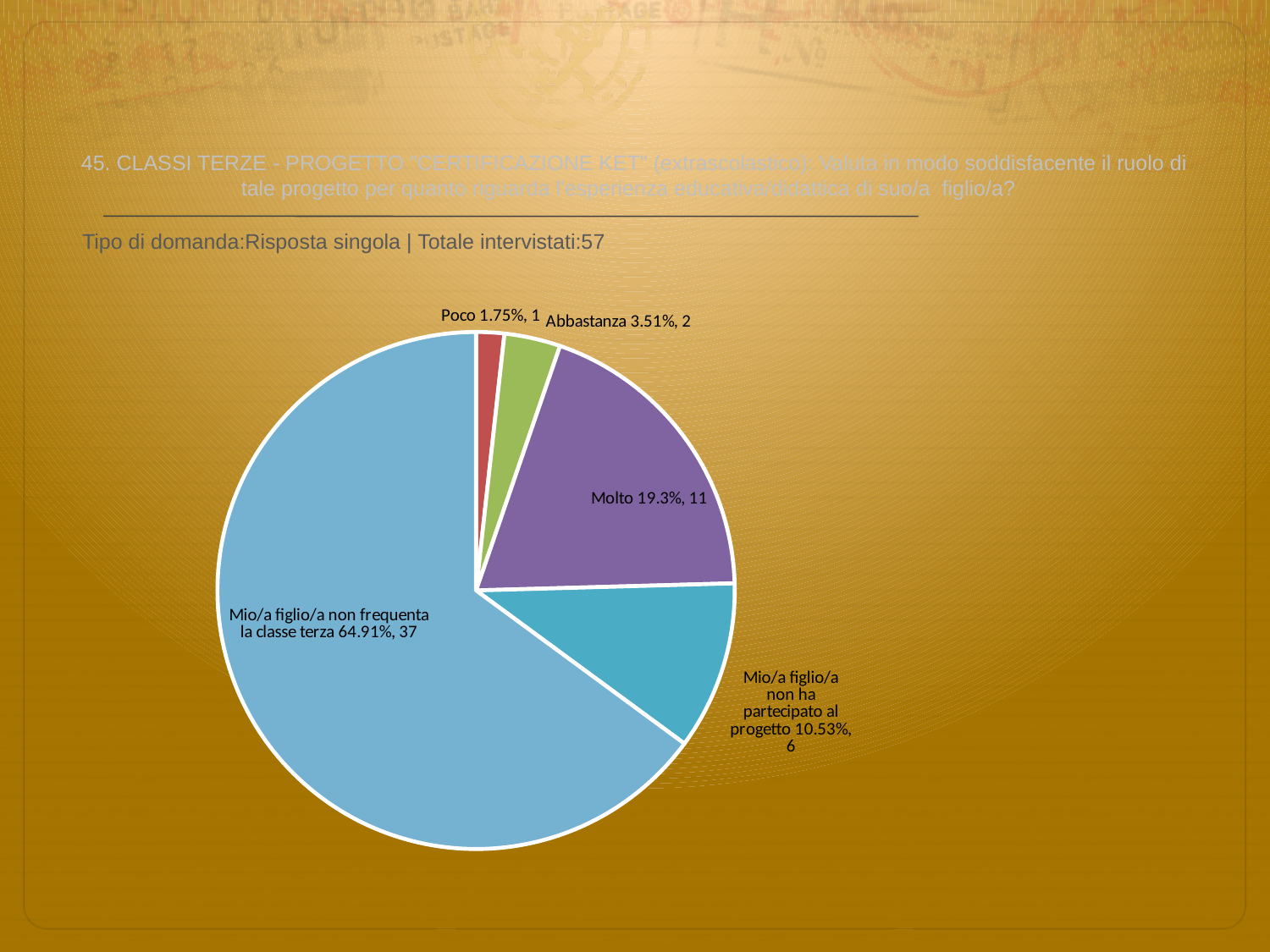
How many respondents are in the 'Abbastanza' slice? 2 Which slice is larger, 'Abbastanza' or 'Molto'? Molto What kind of chart is shown on the slide? pie chart How many respondents are in the 'Mio/a figlio/a non ha partecipato al progetto' slice? 6 What is the difference in respondent count between 'Molto' and 'Mio/a figlio/a non ha partecipato al progetto'? 5 Which slice is the smallest? Poco What percentage share does the 'Poco' slice have? 1.75% What percentage share does the slice 'Molto' have? 19.3% What percentage share does the slice 'Mio/a figlio/a non frequenta la classe terza' have? 64.91% How many slices does the pie chart have? 5 How many respondents are in the 'Molto' slice? 11 Which slice is the largest? Mio/a figlio/a non frequenta la classe terza